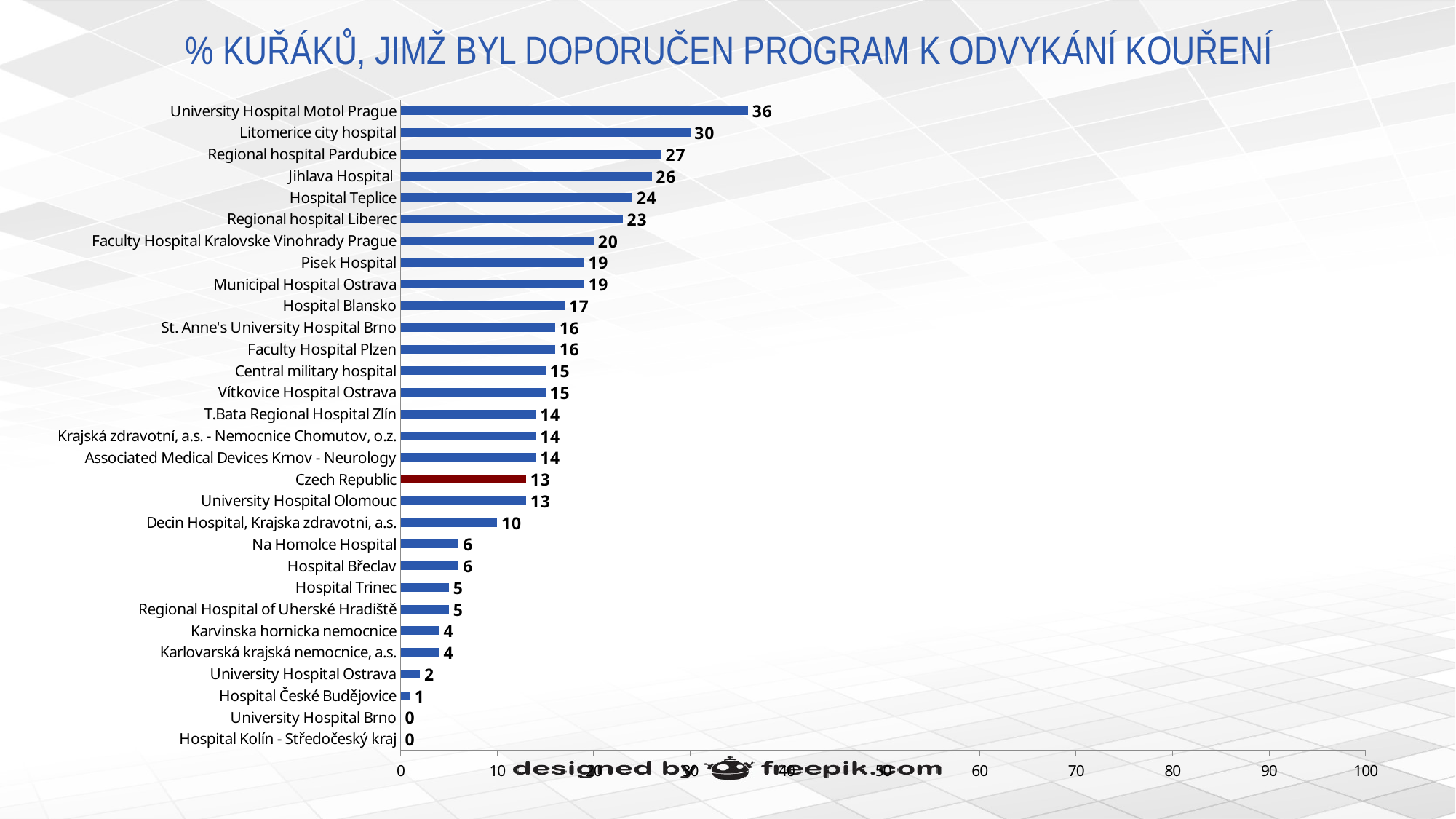
Which bar is coloured dark red instead of blue? Czech Republic What is the value for University Hospital Motol Prague? 36 What is the value for Decin Hospital, Krajska zdravotni, a.s.? 10 Is the value for Regional hospital Pardubice greater or less than 20? greater What is the value for Hospital Teplice? 24 Which is larger, the value for Regional hospital Liberec or the value for Hospital Blansko? Regional hospital Liberec Which category has the highest value? University Hospital Motol Prague What is the difference between the values for Litomerice city hospital and Jihlava Hospital? 4 What is the difference between the values for University Hospital Motol Prague and Czech Republic? 23 What is the value for Czech Republic? 13 What kind of chart is shown on the slide? bar chart How many categories are shown on the chart? 30